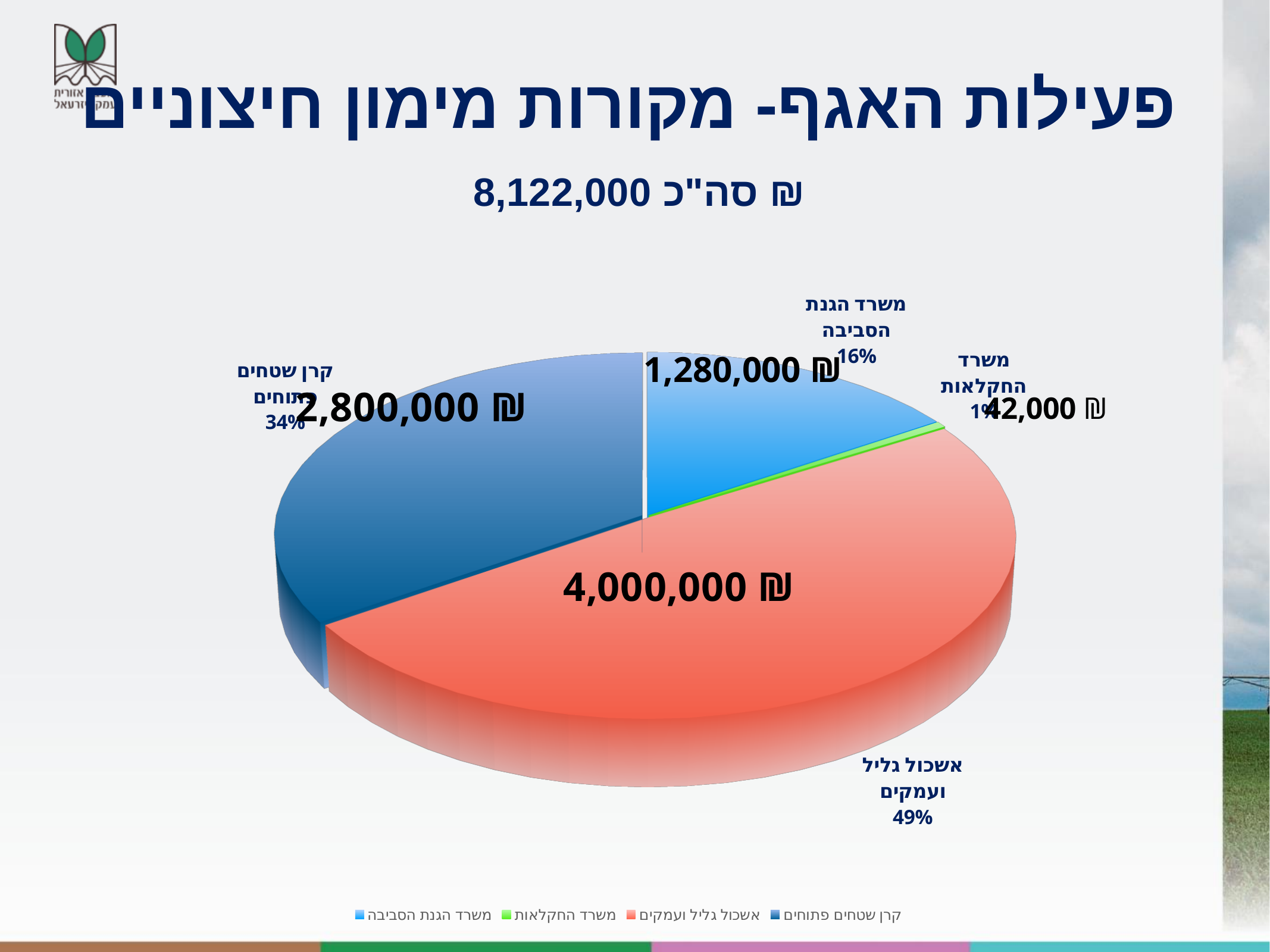
How many entries does the legend list? 4 What share of the pie does קרן שטחים פתוחים represent? 34% What kind of chart is shown on the slide? pie chart Which category has the largest slice of the pie? אשכול גליל ועמקים What is the value for משרד החקלאות? 42,000 ₪ Which category has the smallest slice of the pie? משרד החקלאות How many slices does the pie chart have? 4 What is the value for משרד הגנת הסביבה? 1,280,000 ₪ What is the value for אשכול גליל ועמקים? 4,000,000 ₪ Which is larger, the value for משרד הגנת הסביבה or the value for משרד החקלאות? משרד הגנת הסביבה What is the difference between the values for אשכול גליל ועמקים and קרן שטחים פתוחים? 1,200,000 ₪ What is the value for קרן שטחים פתוחים? 2,800,000 ₪